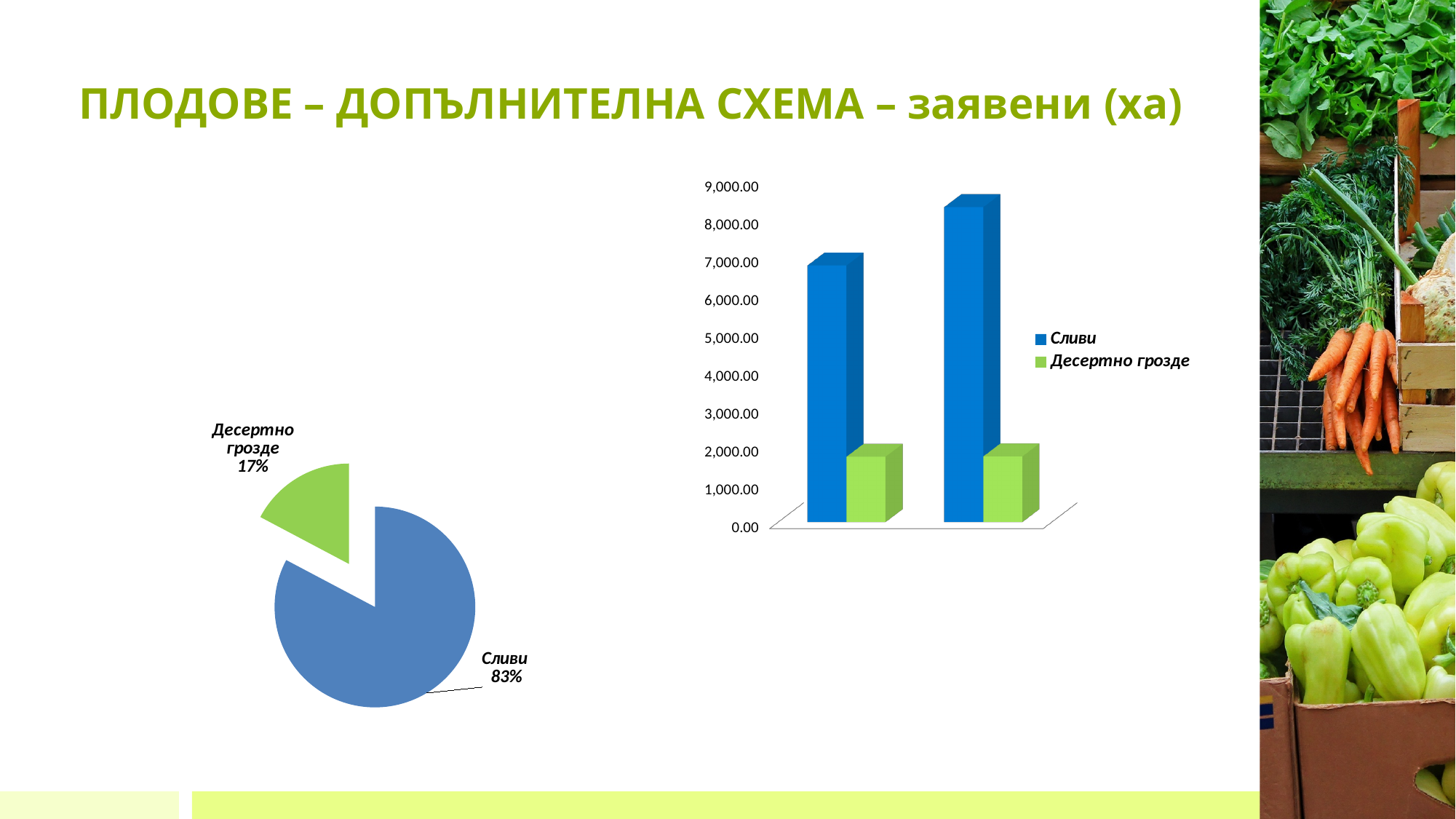
In the pie chart on the left, what share does Десертно грозде have? 17% In the bar chart on the right, is the value for Сливи in the right-hand group greater or less than 8,000.00? greater In the bar chart on the right, which series has the larger value in the right-hand group, Сливи or Десертно грозде? Сливи In the bar chart on the right, which colour represents Сливи in the legend? Blue In the bar chart on the right, how many groups of bars are plotted? 2 What kind of chart is the chart on the right of the slide? Bar chart In the pie chart on the left, how many slices are there? 2 In the bar chart on the right, is the value for Десертно грозде in the left-hand group greater or less than 2,000.00? less What kind of chart is the chart on the left of the slide? Pie chart In the bar chart on the right, how many series does the legend list? 2 In the pie chart on the left, what share does Сливи have? 83% In the pie chart on the left, which slice is the largest? Сливи